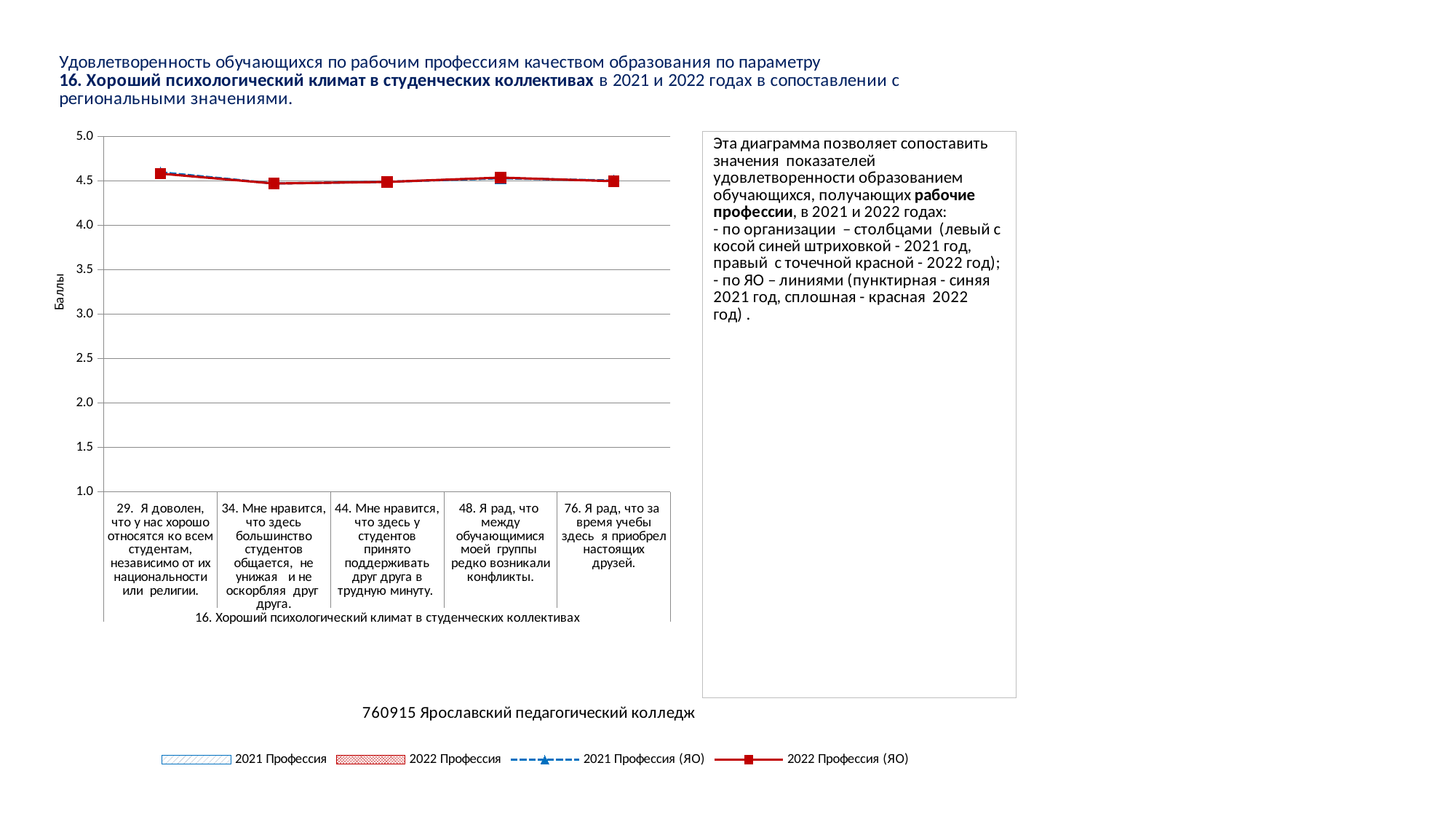
Is the value of the 2021 Профессия (ЯО) line for category 48 greater or less than 3.5? greater Is the value of the 2022 Профессия (ЯО) line for category 29 greater or less than 4.0? greater How many categories are shown on the x axis of the chart? 5 What is the name of the last series listed in the chart legend? 2022 Профессия (ЯО) On the 2022 Профессия (ЯО) line, which is larger: the value for category 29 or the value for category 34? category 29 Does the 2022 Профессия (ЯО) line rise or fall from category 29 to category 34? fall What is the lowest value shown on the vertical axis of the chart? 1.0 How many series does the chart legend list? 4 Is the value of the 2022 Профессия (ЯО) line for category 76 greater or less than 4.0? greater What is the label of the vertical axis of the chart? Баллы